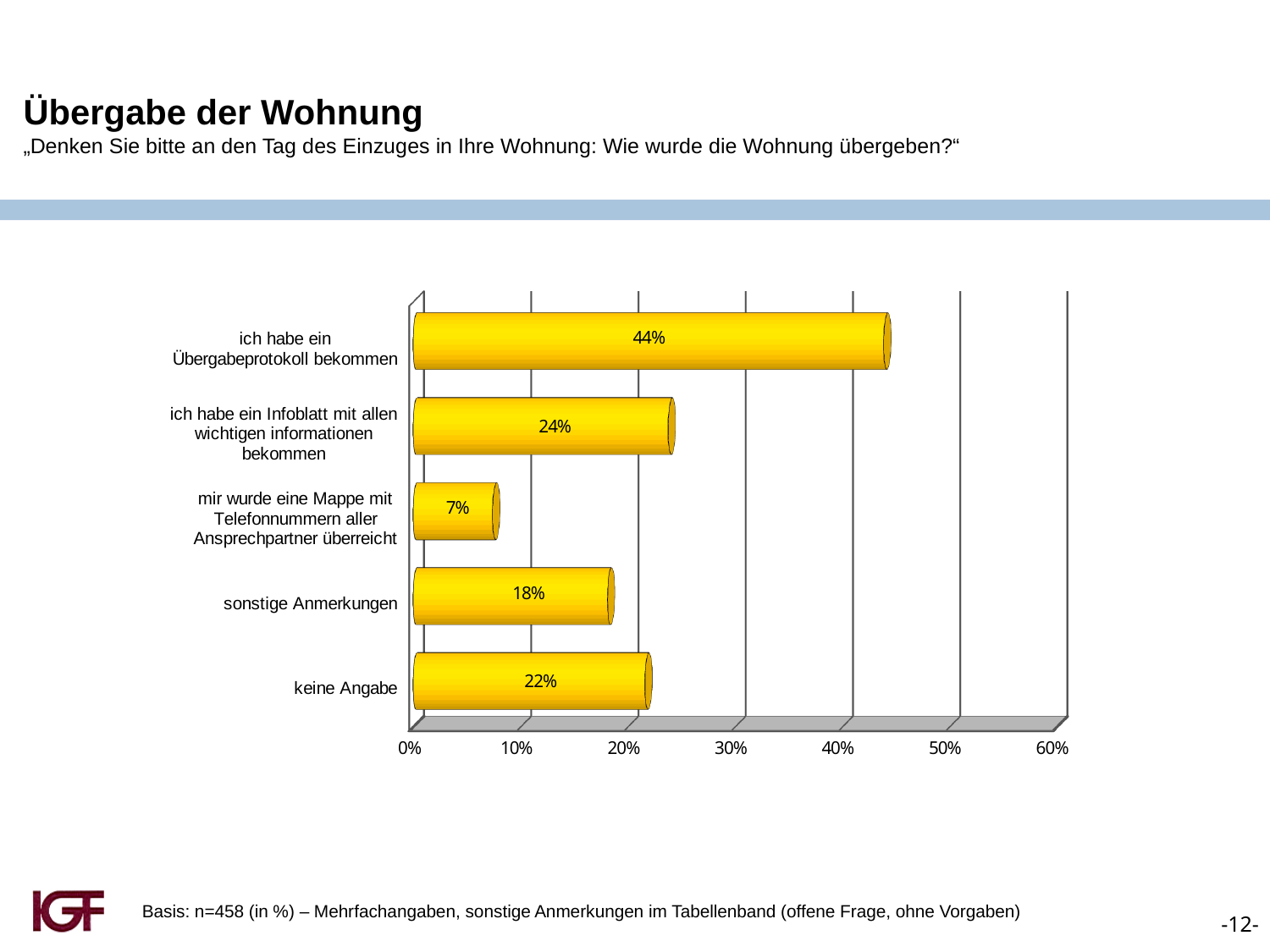
Which is larger: "sonstige Anmerkungen" or "keine Angabe"? keine Angabe What is the maximum value shown on the x axis? 60% What kind of chart is shown on the slide? bar chart What percentage of respondents said "ich habe ein Übergabeprotokoll bekommen"? 44% Which category has the highest value? ich habe ein Übergabeprotokoll bekommen What is the difference between "ich habe ein Übergabeprotokoll bekommen" and "ich habe ein Infoblatt mit allen wichtigen informationen bekommen"? 20% What is the value for "keine Angabe"? 22% What is the value for "mir wurde eine Mappe mit Telefonnummern aller Ansprechpartner überreicht"? 7% Which category has the lowest value? mir wurde eine Mappe mit Telefonnummern aller Ansprechpartner überreicht What is the value for "ich habe ein Infoblatt mit allen wichtigen informationen bekommen"? 24% Is the value for "sonstige Anmerkungen" greater or less than 20%? less How many categories are shown in the chart? 5